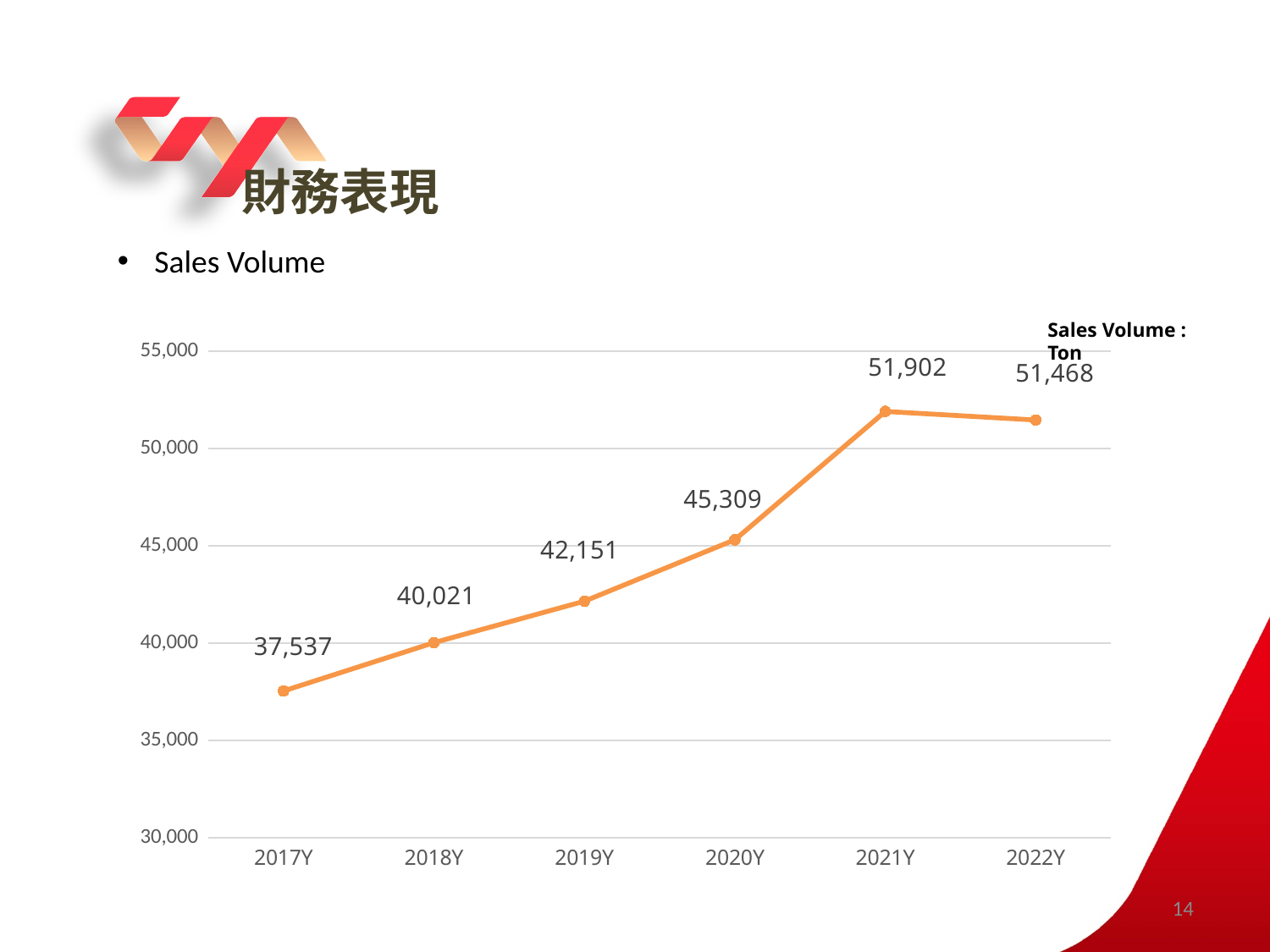
What kind of chart is shown on the slide? line chart Is the sales volume for 2019Y greater or less than 45,000? less What is the sales volume for 2020Y? 45,309 What is the sales volume for 2017Y? 37,537 Which year has the highest sales volume? 2021Y What is the difference in sales volume between 2021Y and 2020Y? 6,593 What unit is the sales volume measured in, according to the chart? Ton What is the difference in sales volume between 2018Y and 2017Y? 2,484 What is the sales volume for 2022Y? 51,468 How many years are plotted on the chart? 6 Which year has the lowest sales volume? 2017Y Which year has a larger sales volume, 2019Y or 2020Y? 2020Y